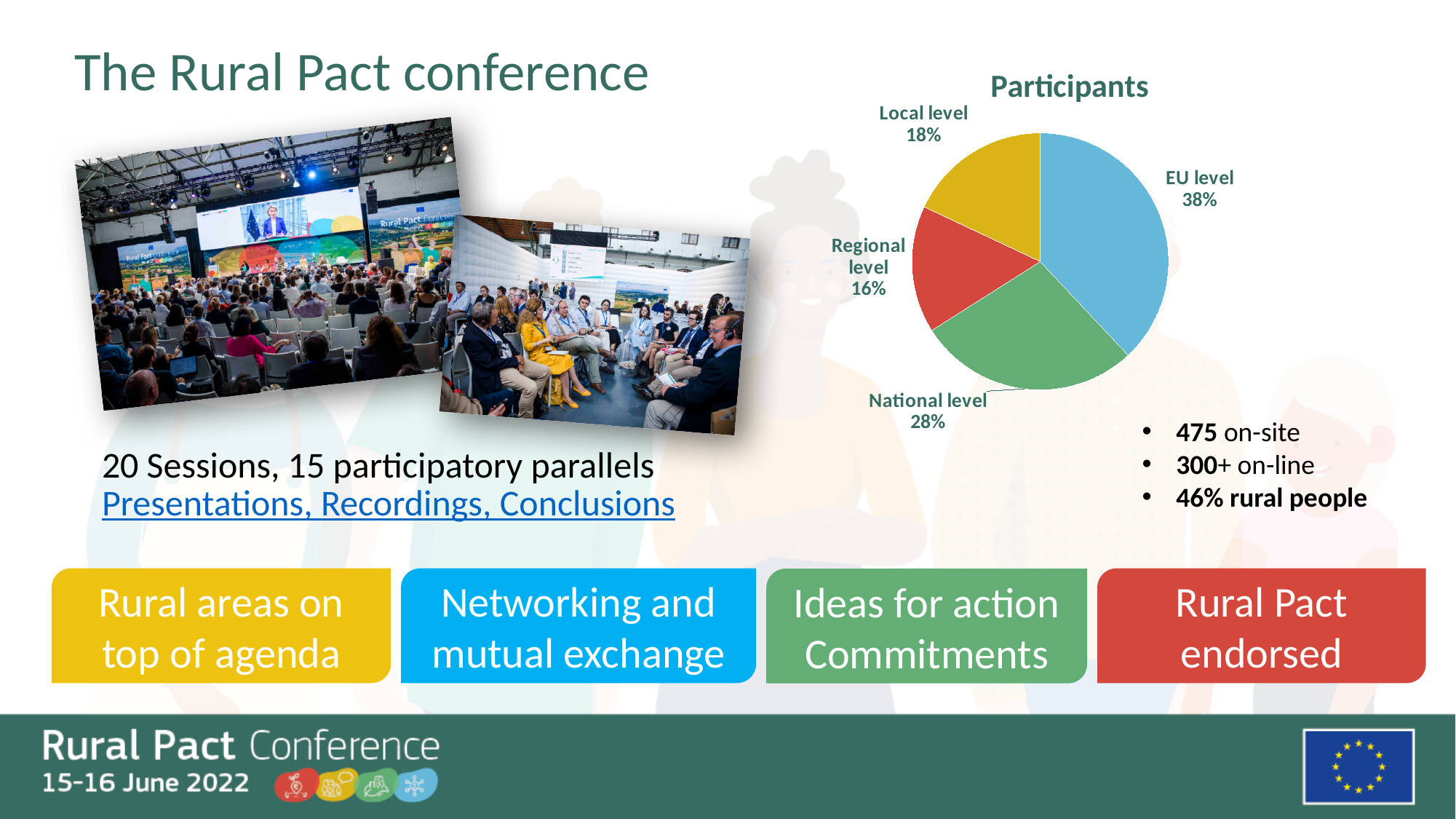
What colour is the EU level slice in the Participants pie chart? blue How many slices does the Participants pie chart have? 4 Which share is larger, Local level or Regional level? Local level Which level has the smallest share of participants? Regional level What is the difference in percentage points between the EU level and National level shares? 10 What is the title of the pie chart? Participants What share of participants were from the EU level? 38% What kind of chart is the Participants chart? pie chart Which level has the largest share of participants? EU level What share of participants were from the Local level? 18% What share of participants were from the Regional level? 16% What share of participants were from the National level? 28%